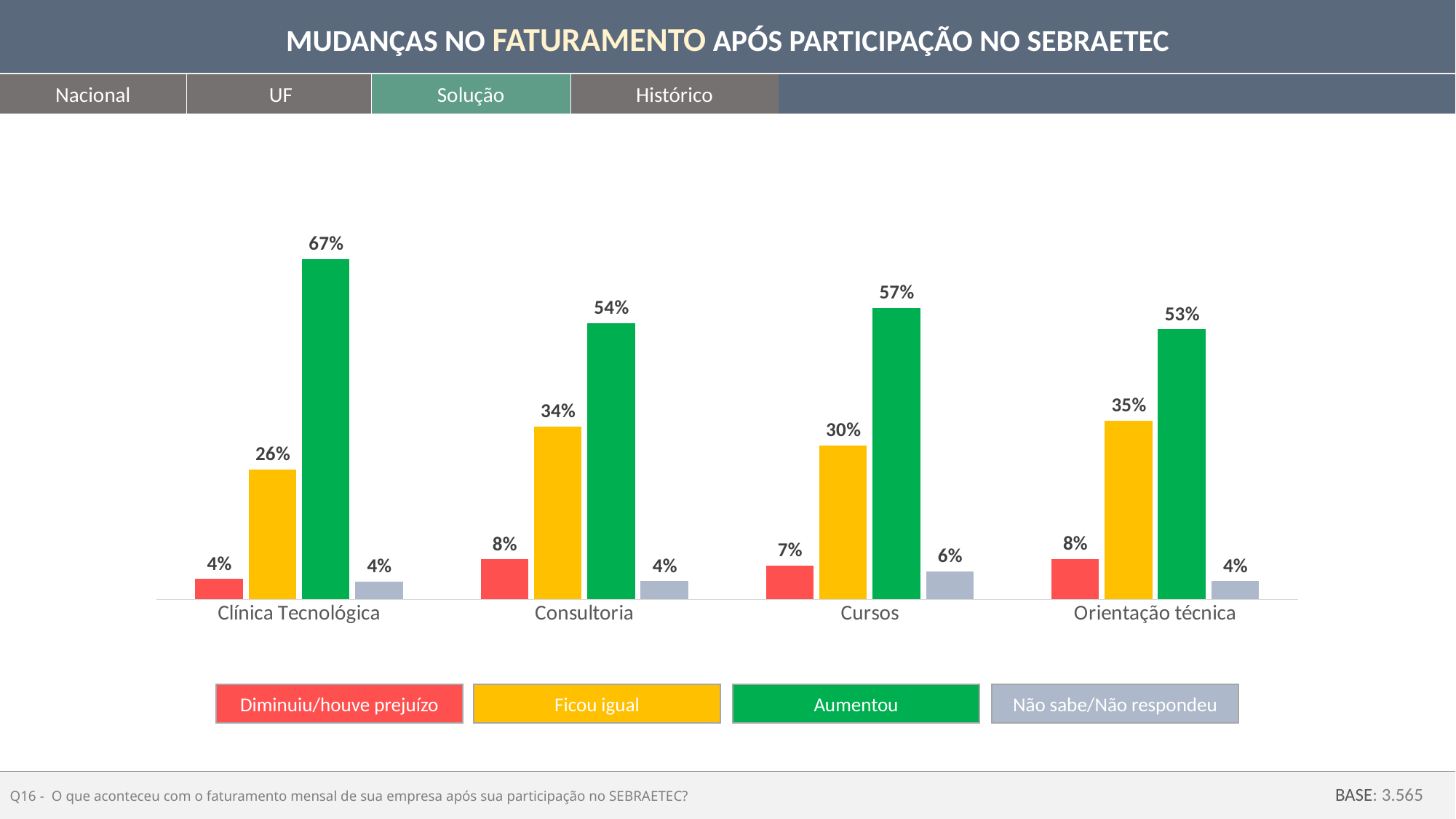
What is the value for "Aumentou" in the Clínica Tecnológica category? 67% What is the value for "Ficou igual" in the Consultoria category? 34% Which is larger: the "Ficou igual" value for Cursos or for Orientação técnica? Orientação técnica How many series does the legend list? 4 What is the difference between the "Aumentou" values for Clínica Tecnológica and Orientação técnica? 14% What is the value for "Não sabe/Não respondeu" in the Orientação técnica category? 4% Which category has the lowest value for "Ficou igual"? Clínica Tecnológica Which category has the highest value for "Aumentou"? Clínica Tecnológica What is the value for "Diminuiu/houve prejuízo" in the Cursos category? 7% How many categories are shown on the x axis? 4 Which colour represents the "Aumentou" series? Green What kind of chart is shown on the slide? Bar chart